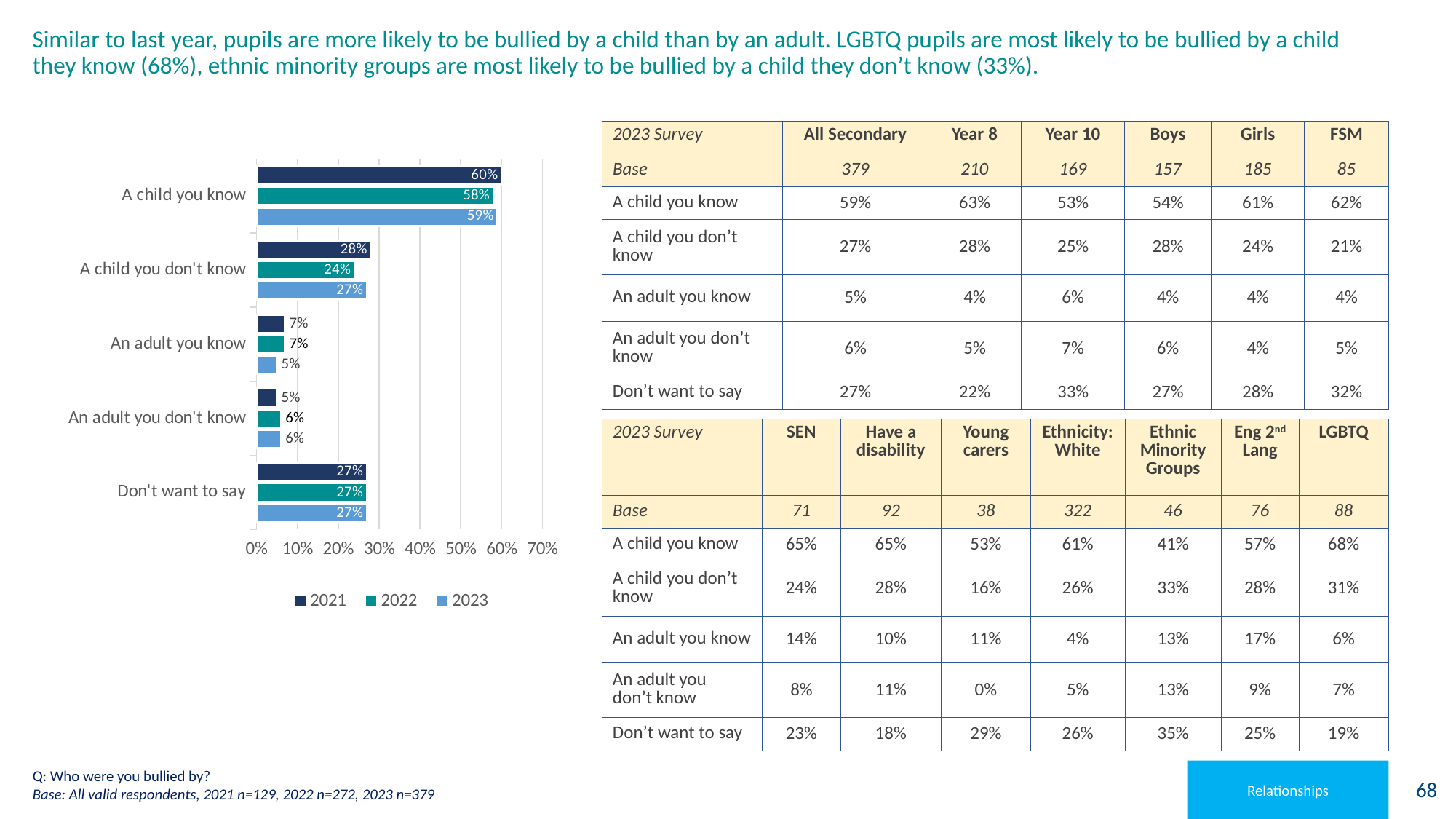
How many categories are shown on the chart? 5 What is the 2022 value for 'A child you don't know'? 24% Is the 2022 value for 'A child you know' greater or less than 50%? greater What is the 2023 value for 'A child you know'? 59% What kind of chart is shown on the slide? bar chart Which category has the highest value for the 2021 series? A child you know What is the difference between the 2021 and 2022 values for 'A child you know'? 2% What is the 2021 value for 'An adult you don't know'? 5% Which category has the lowest value for the 2023 series? An adult you know Which is larger for 'A child you don't know': the 2021 value or the 2023 value? 2021 How many series does the chart legend list? 3 Which series is shown in the darkest colour in the legend? 2021